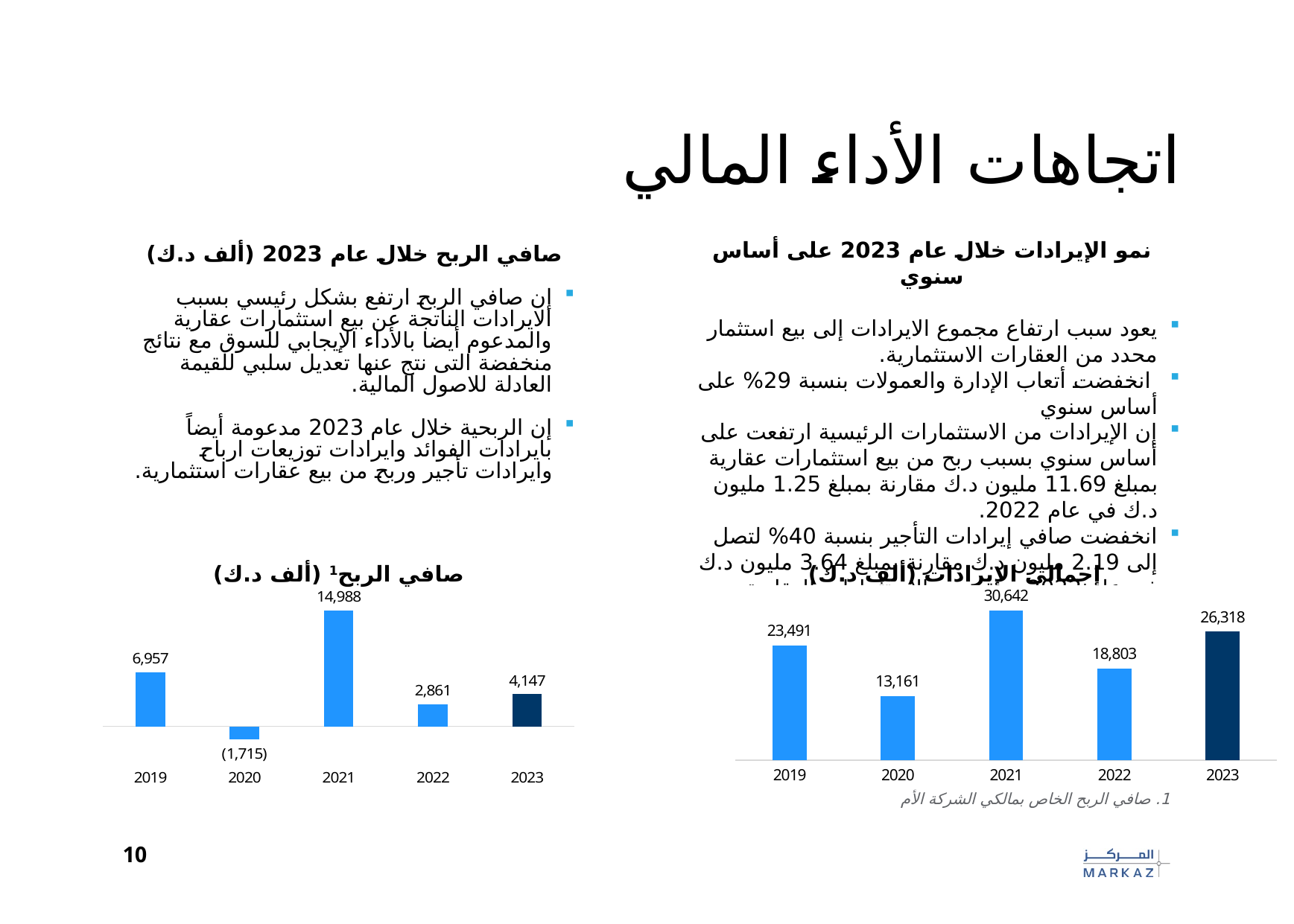
In the right chart (total revenues), what is the value for 2020? 13,161 In the left chart (net profit), how many years are shown on the x axis? 5 In the left chart (net profit), what is the difference between the 2023 value and the 2022 value? 1,286 In the left chart (net profit), what is the value for 2020? (1,715) In the right chart (total revenues, إجمالي الإيرادات), what is the value for 2023? 26,318 What type of chart is the right chart (total revenues)? Bar chart In the left chart (net profit), which year has the lowest value? 2020 In the left chart (net profit, صافي الربح), what is the value for 2021? 14,988 In the right chart (total revenues), which is larger, the value for 2019 or the value for 2022? 2019 In the right chart (total revenues), what is the difference between the 2021 value and the 2022 value? 11,839 In the left chart (net profit), which year has the highest value? 2021 In the right chart (total revenues), which year has the highest value? 2021